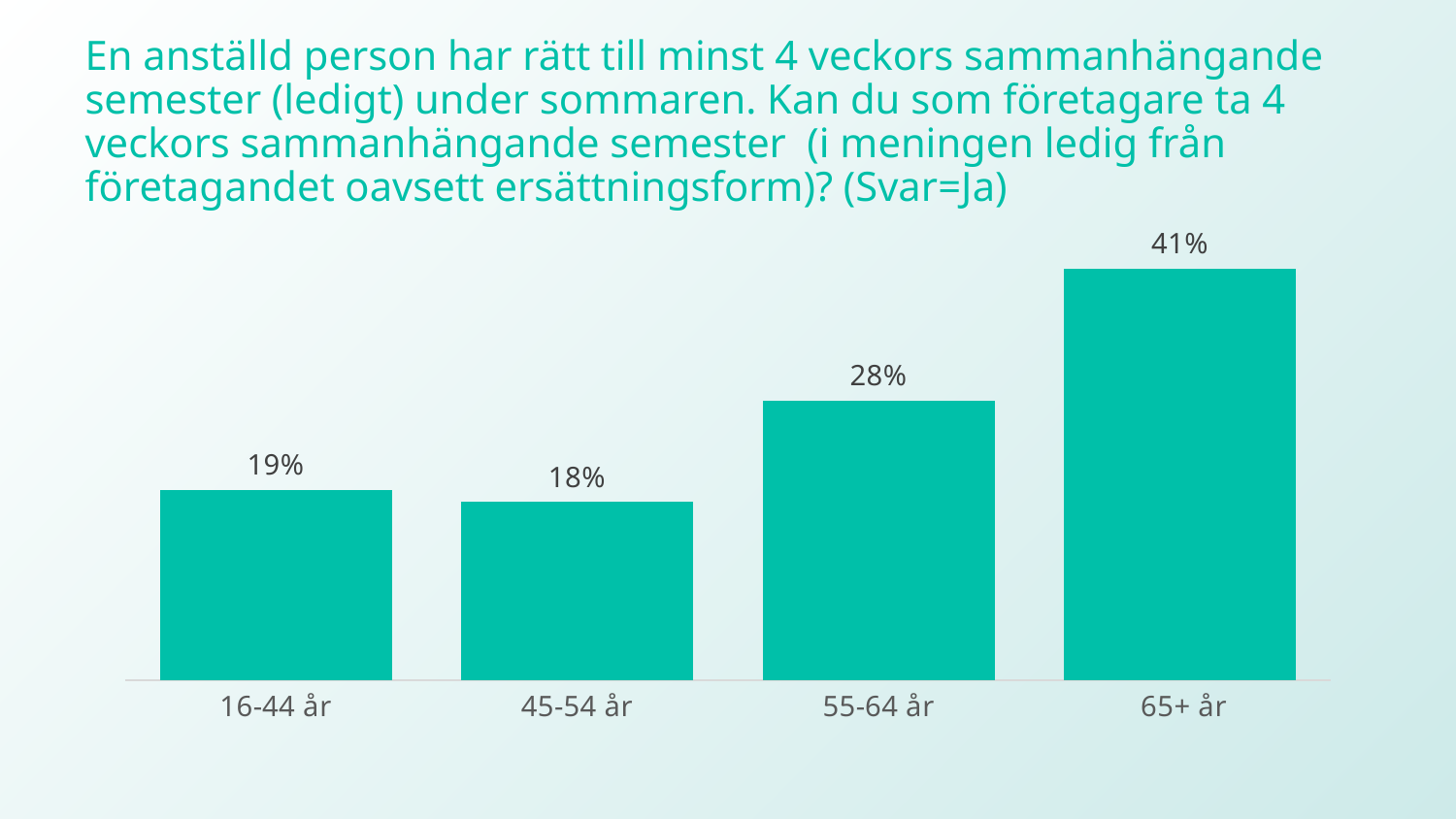
What kind of chart is shown on the slide? Bar chart Which age group has the highest value? 65+ år What is the value for the 16-44 år age group? 19% What colour are the bars in the chart? Teal How many age groups are shown in the chart? 4 What is the difference between the values for 65+ år and 55-64 år? 13% What is the value for the 65+ år age group? 41% What is the value for the 55-64 år age group? 28% What is the difference between the values for 16-44 år and 45-54 år? 1% What is the value for the 45-54 år age group? 18% Which age group has the lowest value? 45-54 år Which is larger, the value for 55-64 år or the value for 16-44 år? 55-64 år